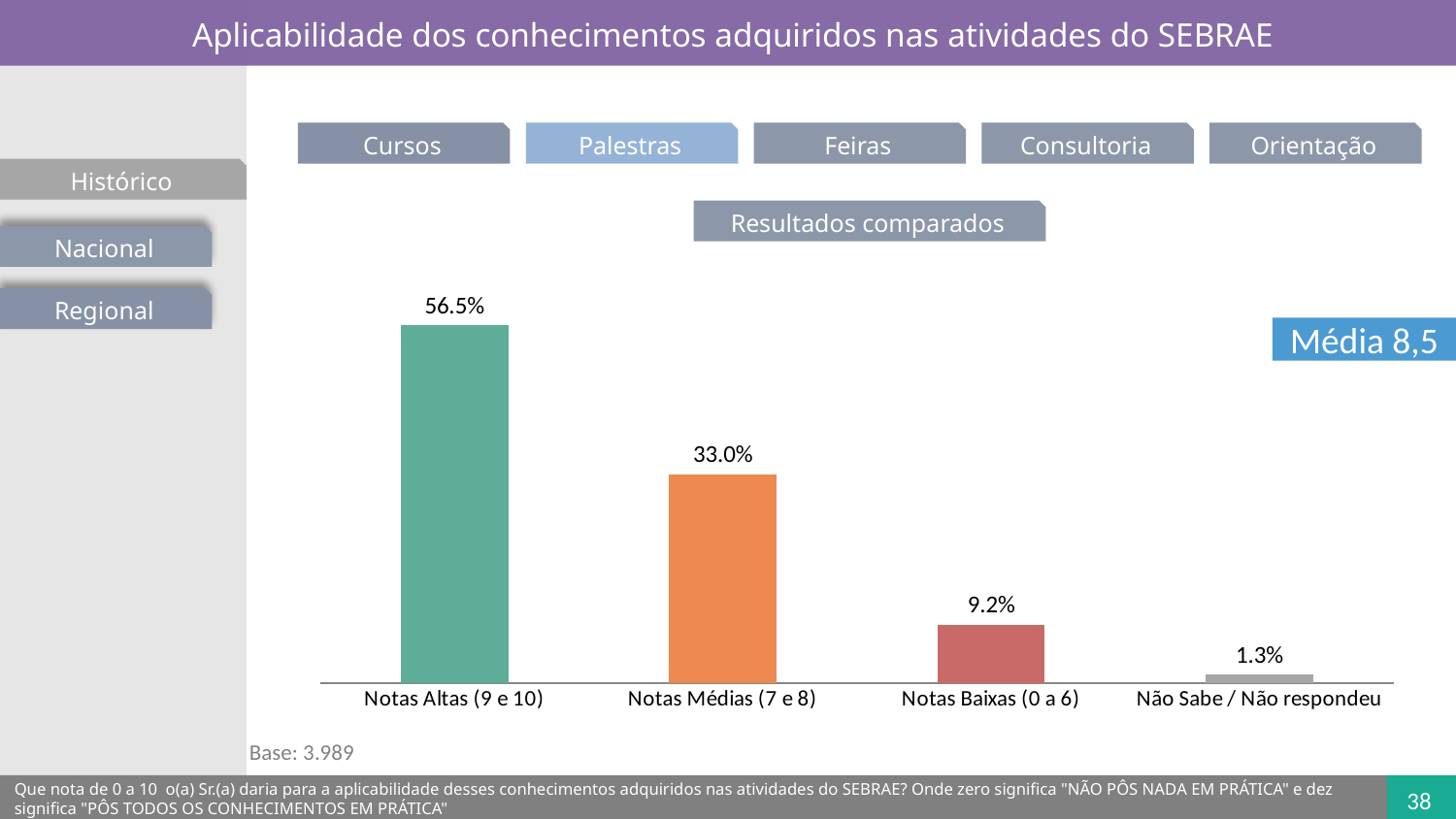
What is the difference between the values for Notas Baixas (0 a 6) and Não Sabe / Não respondeu? 7.9% Which category has the highest value? Notas Altas (9 e 10) What is the value for Notas Altas (9 e 10)? 56.5% Which is larger, the value for Notas Médias (7 e 8) or the value for Notas Baixas (0 a 6)? Notas Médias (7 e 8) What average (Média) is shown on the slide next to the chart? 8,5 What is the value for Notas Baixas (0 a 6)? 9.2% How many categories are shown in the chart? 4 What is the difference between the values for Notas Altas (9 e 10) and Notas Médias (7 e 8)? 23.5% What is the value for Notas Médias (7 e 8)? 33.0% Which category has the lowest value? Não Sabe / Não respondeu What kind of chart is shown on the slide? Bar chart What is the value for Não Sabe / Não respondeu? 1.3%